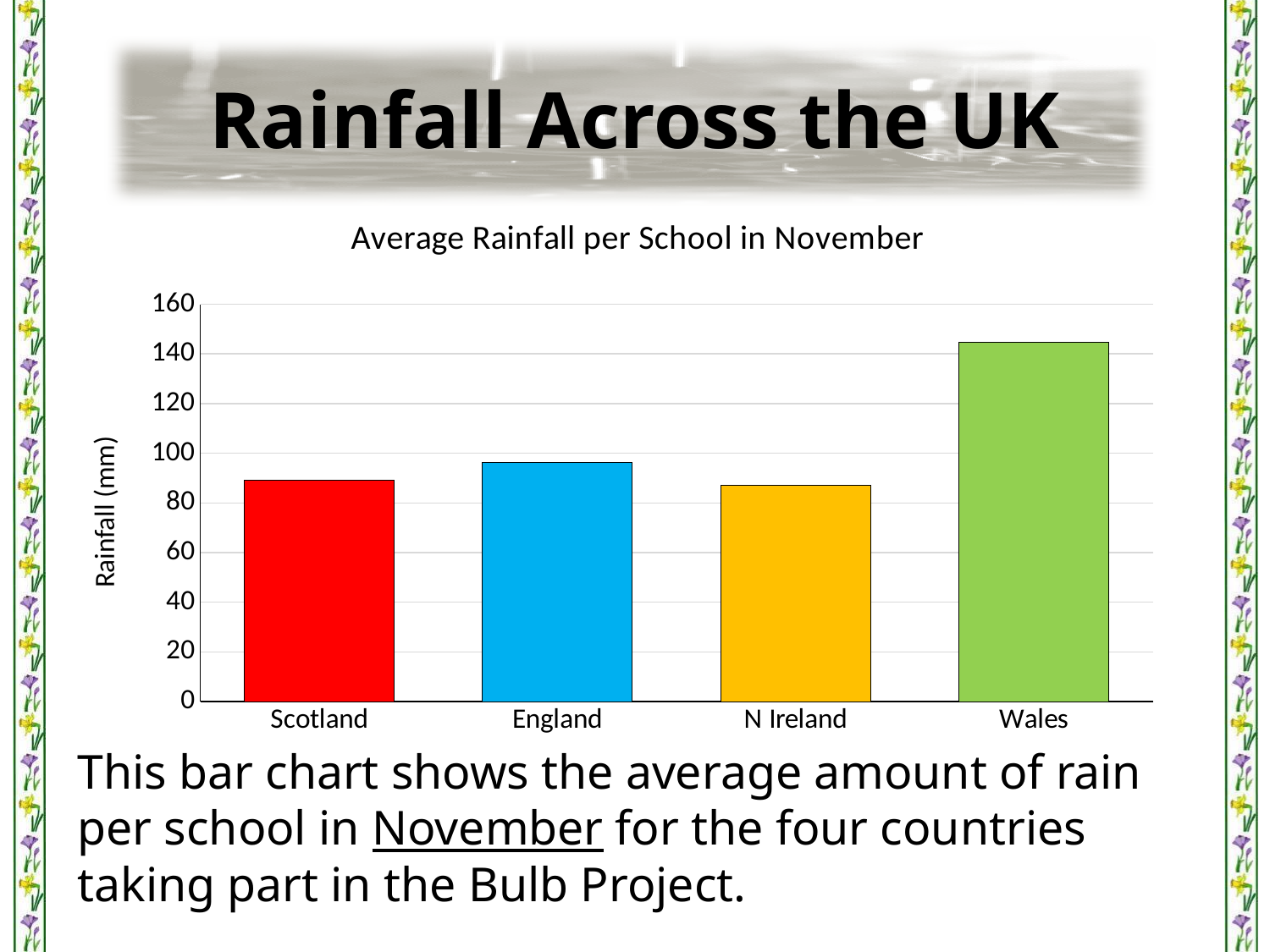
Is the value for N Ireland greater or less than 80? greater Is the value for England greater or less than 100? less What is the label on the vertical axis? Rainfall (mm) What type of chart is shown on the slide? bar chart Which has the higher average rainfall, Wales or England? Wales Is the value for Scotland greater or less than 100? less Which has the higher average rainfall, England or N Ireland? England How many countries are shown on the chart? 4 What is the title of the chart? Average Rainfall per School in November Which country has the highest average rainfall? Wales